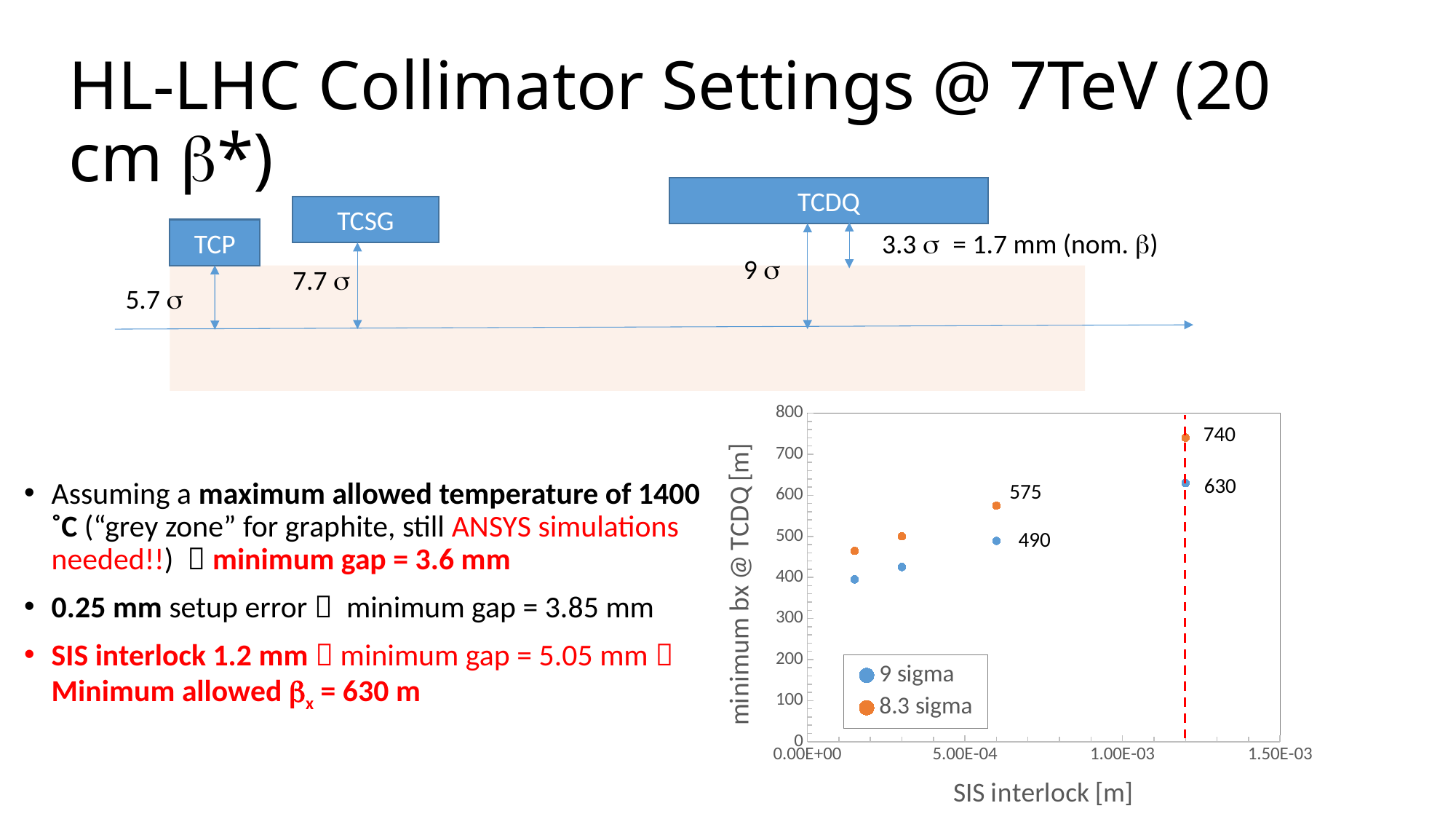
How many series does the chart legend list? 2 What is the difference between the labelled 8.3 sigma and 9 sigma values at the red dashed line? 110 What is the labelled value of the 8.3 sigma point at the red dashed line (SIS interlock of about 1.2E-03 m)? 740 What are the two series named in the chart legend? 9 sigma and 8.3 sigma How many data points are plotted for the 9 sigma series? 4 What is the labelled value of the 9 sigma point at the red dashed line (SIS interlock of about 1.2E-03 m)? 630 What kind of chart is shown on the slide? scatter chart What is the labelled value of the 8.3 sigma point at an SIS interlock of about 6.00E-04 m? 575 What is the labelled value of the 9 sigma point at an SIS interlock of about 6.00E-04 m? 490 What is the y-axis label of the chart? minimum bx @ TCDQ [m] Which series has the higher value at the red dashed line, 9 sigma or 8.3 sigma? 8.3 sigma Do the 9 sigma values rise or fall as the SIS interlock increases along the x axis? rise